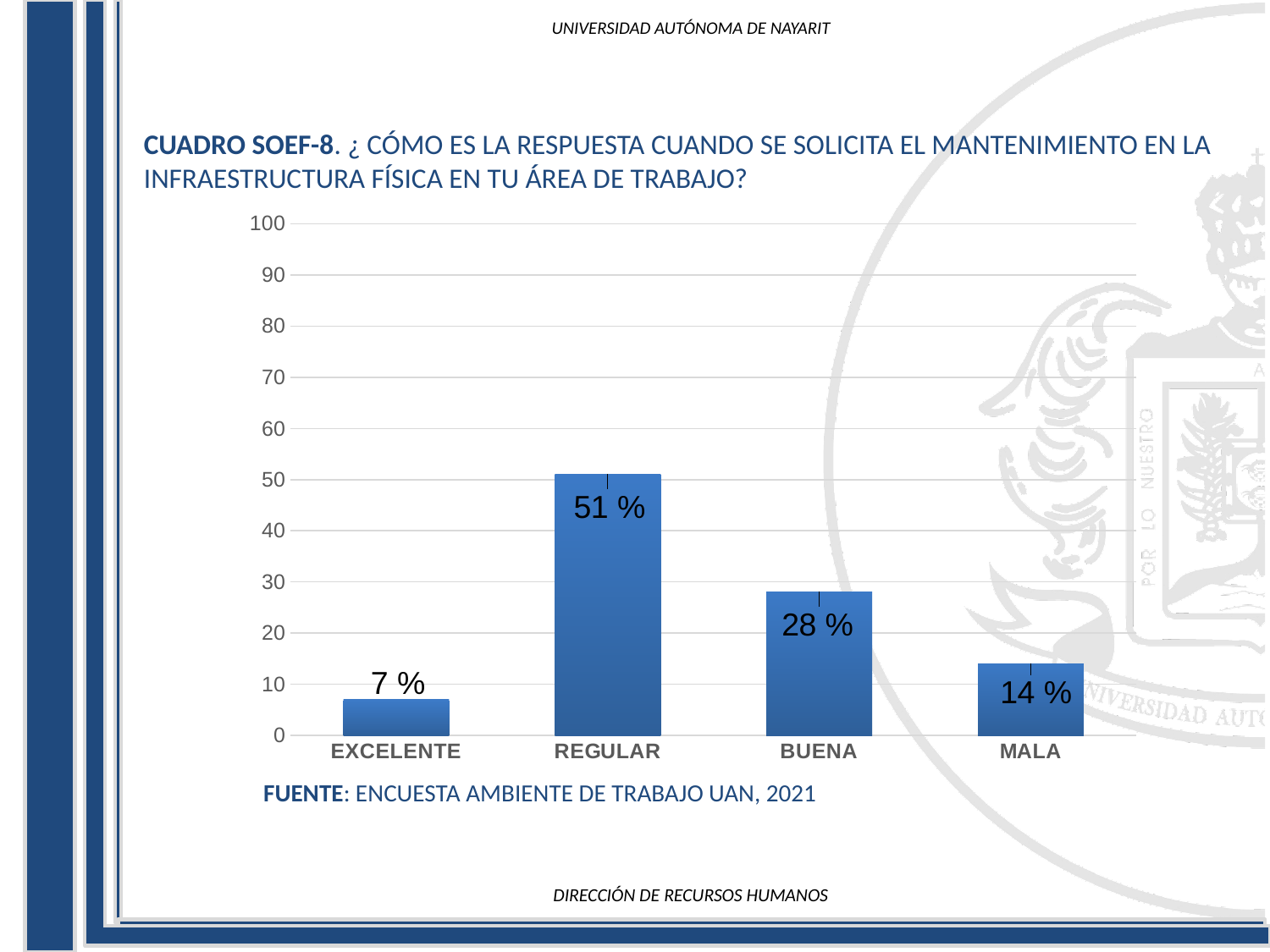
What kind of chart is shown on the slide? bar chart Which is larger, the value for BUENA or the value for MALA? BUENA What is the difference between the values for REGULAR and BUENA? 23 % What is the value for MALA? 14 % Which category has the lowest value? EXCELENTE What is the source cited below the chart? ENCUESTA AMBIENTE DE TRABAJO UAN, 2021 What is the value for BUENA? 28 % Which category has the highest value? REGULAR What is the value for EXCELENTE? 7 % How many categories are shown on the x axis? 4 What is the value for REGULAR? 51 % Is the value for REGULAR greater or less than 50? greater